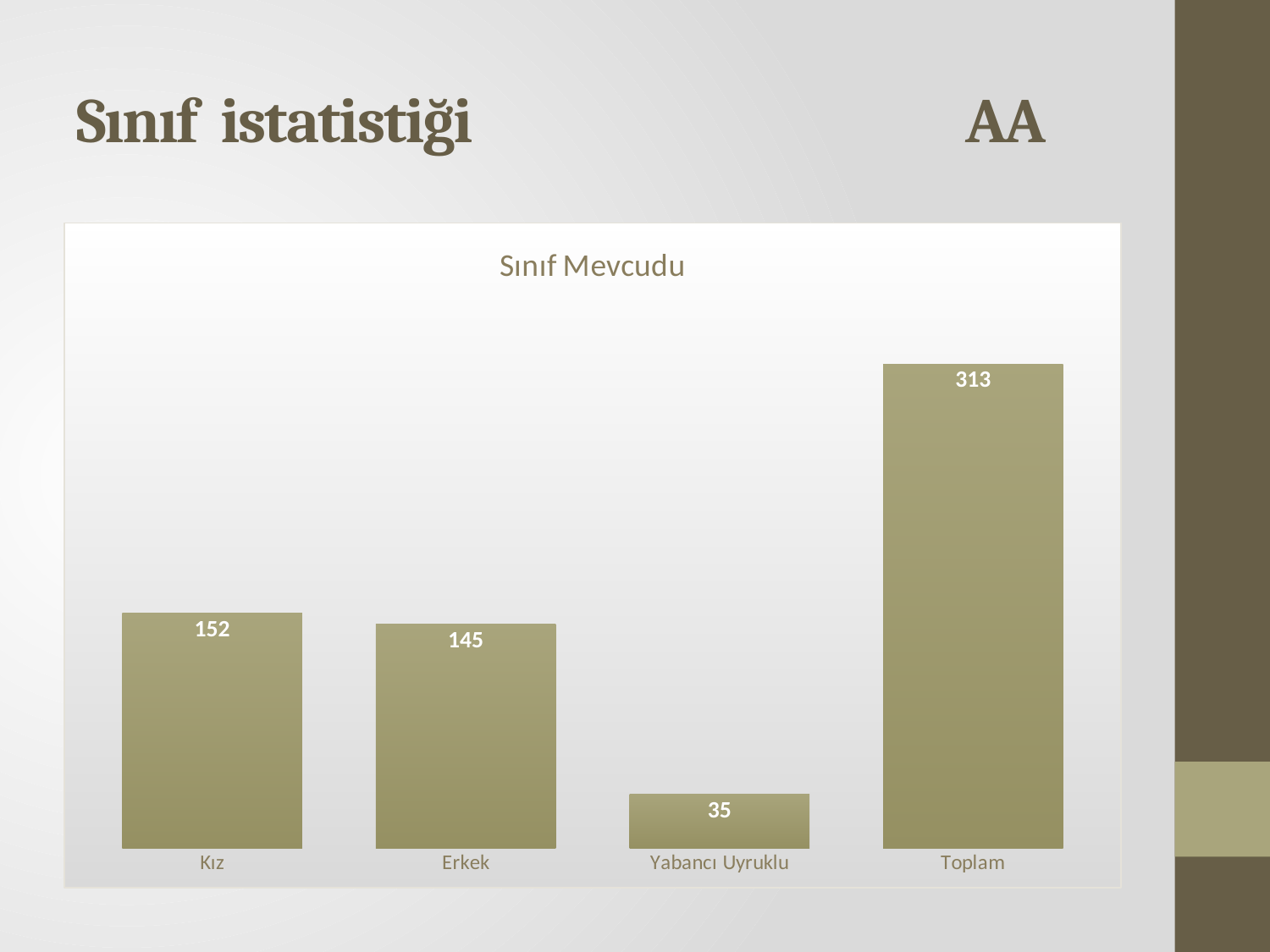
What is the value for Yabancı Uyruklu? 35 What is the title of the chart? Sınıf Mevcudu What is the value for Toplam? 313 How many categories are shown on the x axis? 4 What is the difference between the values for Toplam and Yabancı Uyruklu? 278 Which category has the lowest value? Yabancı Uyruklu Which category has the highest value? Toplam What is the value for Kız? 152 What kind of chart is shown on the slide? Bar chart What is the value for Erkek? 145 What is the difference between the values for Kız and Erkek? 7 Which is larger, the value for Kız or the value for Erkek? Kız